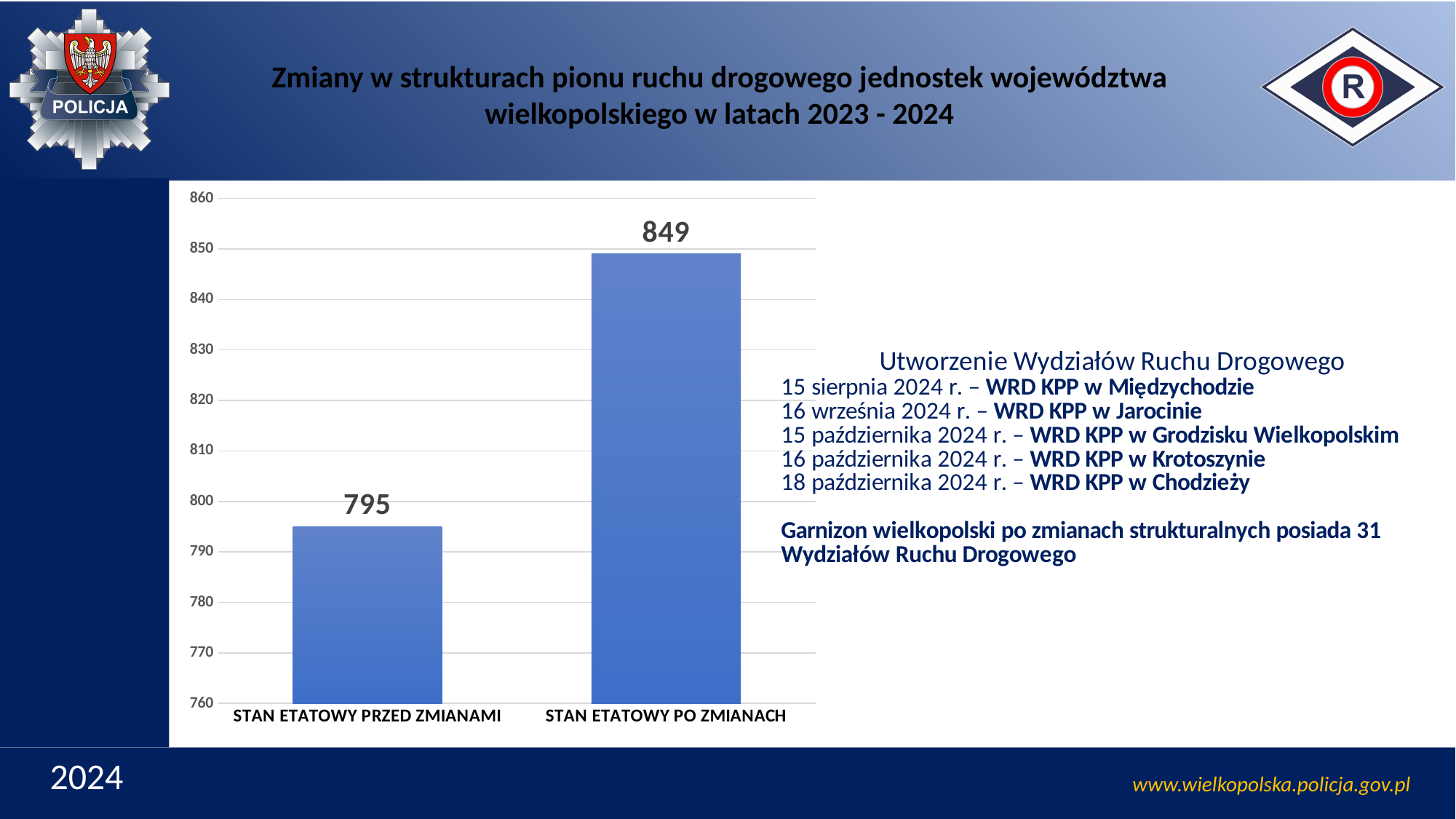
What is the value for STAN ETATOWY PO ZMIANACH? 849 Which category has the highest value? STAN ETATOWY PO ZMIANACH Which is larger: the value for STAN ETATOWY PRZED ZMIANAMI or the value for STAN ETATOWY PO ZMIANACH? STAN ETATOWY PO ZMIANACH What kind of chart is shown on the slide? bar chart What is the value for STAN ETATOWY PRZED ZMIANAMI? 795 How many categories are shown in the chart? 2 What is the highest value shown on the vertical axis of the chart? 860 Which category has the lowest value? STAN ETATOWY PRZED ZMIANAMI What is the difference between the value for STAN ETATOWY PO ZMIANACH and the value for STAN ETATOWY PRZED ZMIANAMI? 54 Is the value for STAN ETATOWY PO ZMIANACH greater or less than 840? greater Do the values rise or fall from the left bar to the right bar? rise Is the value for STAN ETATOWY PRZED ZMIANAMI greater or less than 800? less